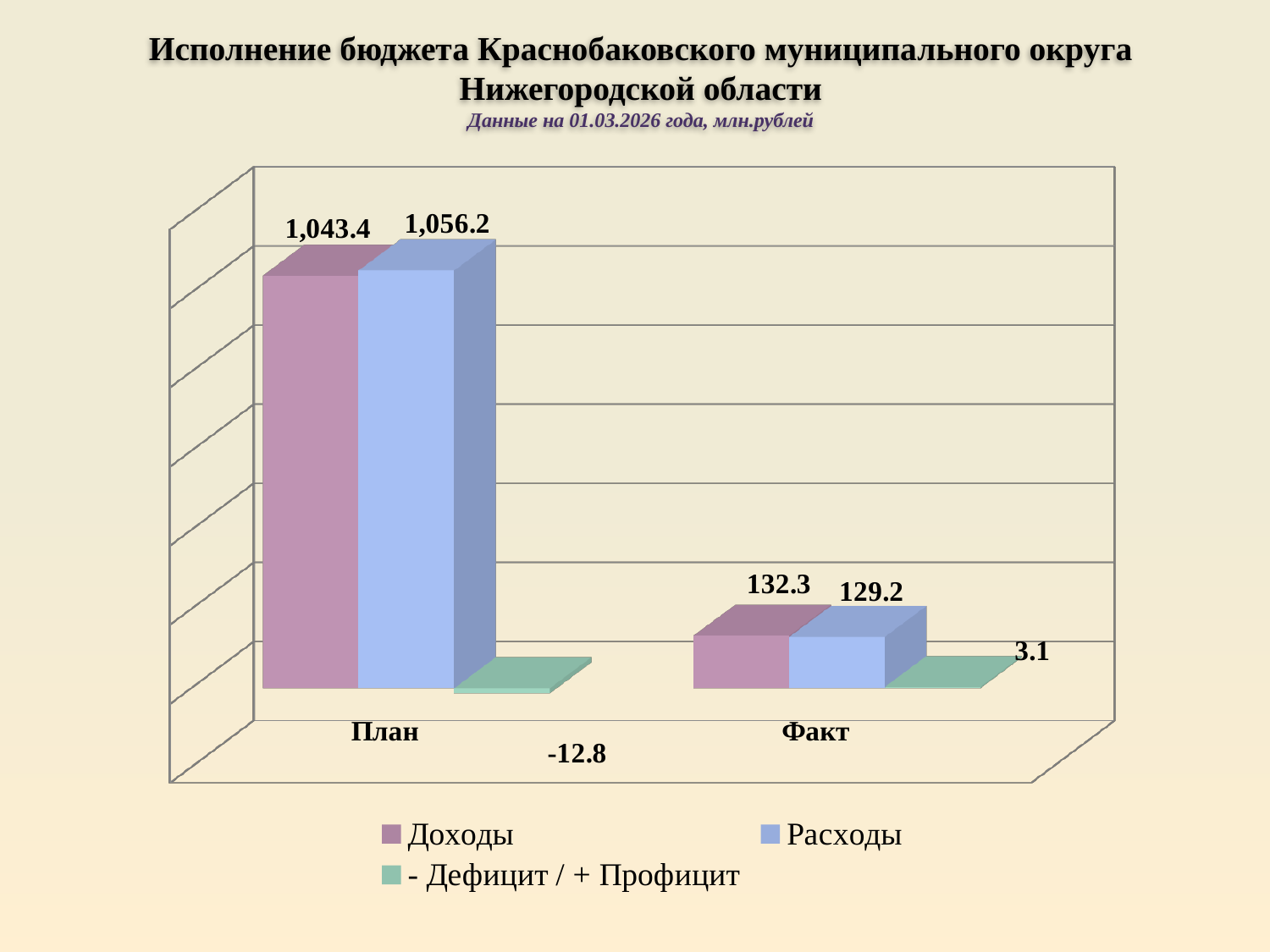
What is the difference between Расходы and Доходы for План? 12.8 What is the value of - Дефицит / + Профицит for План? -12.8 What kind of chart is shown on the slide? Bar chart What is the value of Расходы for План? 1,056.2 Which category has the highest value for Расходы? План What is the value of - Дефицит / + Профицит for Факт? 3.1 For Факт, which is larger: Доходы or Расходы? Доходы What is the value of Расходы for Факт? 129.2 Which category has the lowest value for Доходы? Факт What is the value of Доходы for Факт? 132.3 What is the value of Доходы for План? 1,043.4 How many series does the legend list? 3